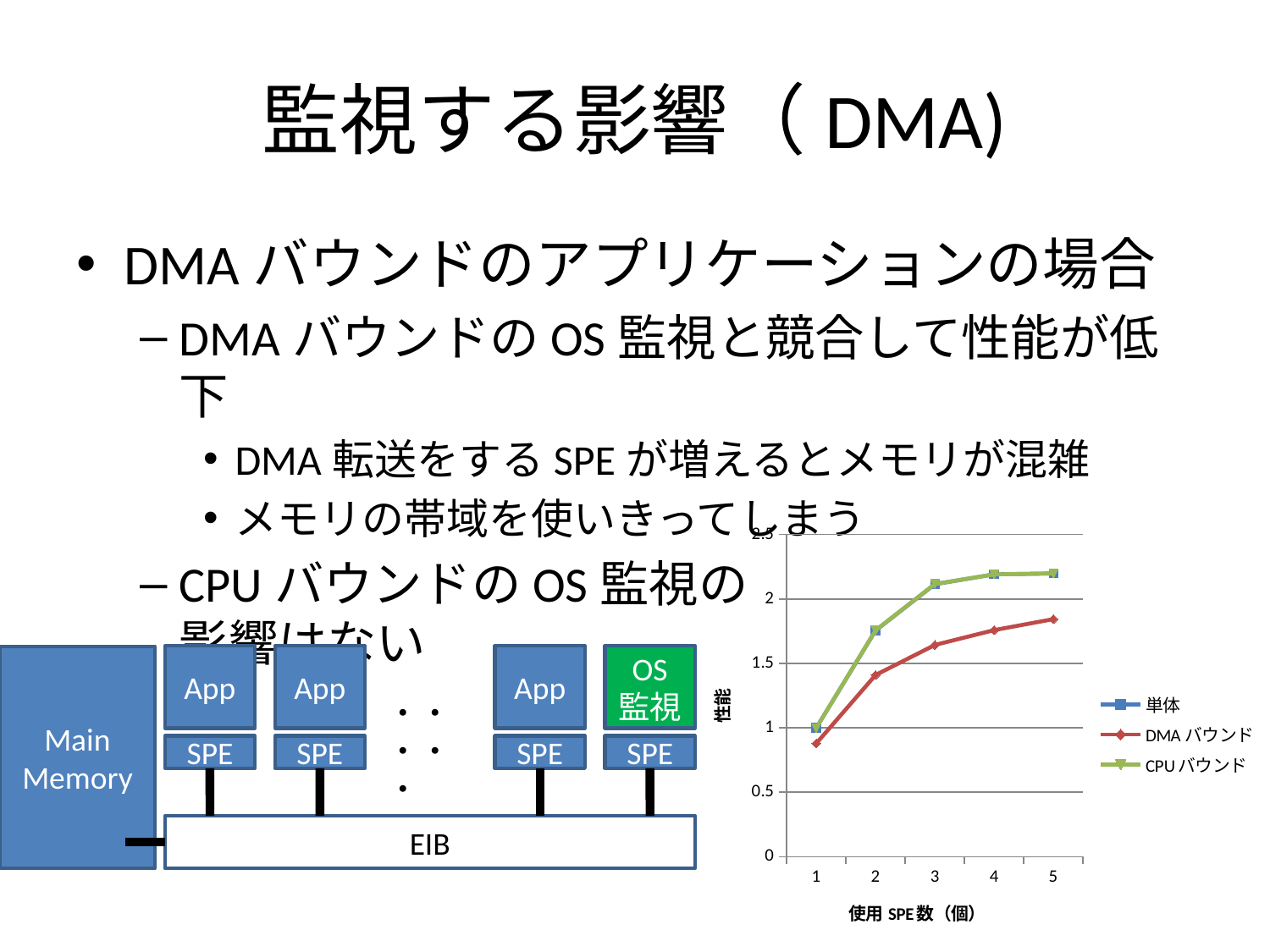
What kind of chart is shown on the slide? line chart Does the DMA バウンド series rise or fall as the number of SPEs increases? rises Is the value of CPU バウンド at 5 SPEs greater or less than 2? greater Is the value of CPU バウンド at 3 SPEs greater or less than 2? greater Which series has the lowest value at 5 SPEs? DMA バウンド How many series does the chart legend list? 3 What is the title of the y axis of the chart? 性能 At 5 SPEs, which is higher: CPU バウンド or DMA バウンド? CPU バウンド Is the value of DMA バウンド at 1 SPE greater or less than 1? less What is the title of the x axis of the chart? 使用 SPE 数（個） How many points along the x axis (使用 SPE 数) does each series have? 5